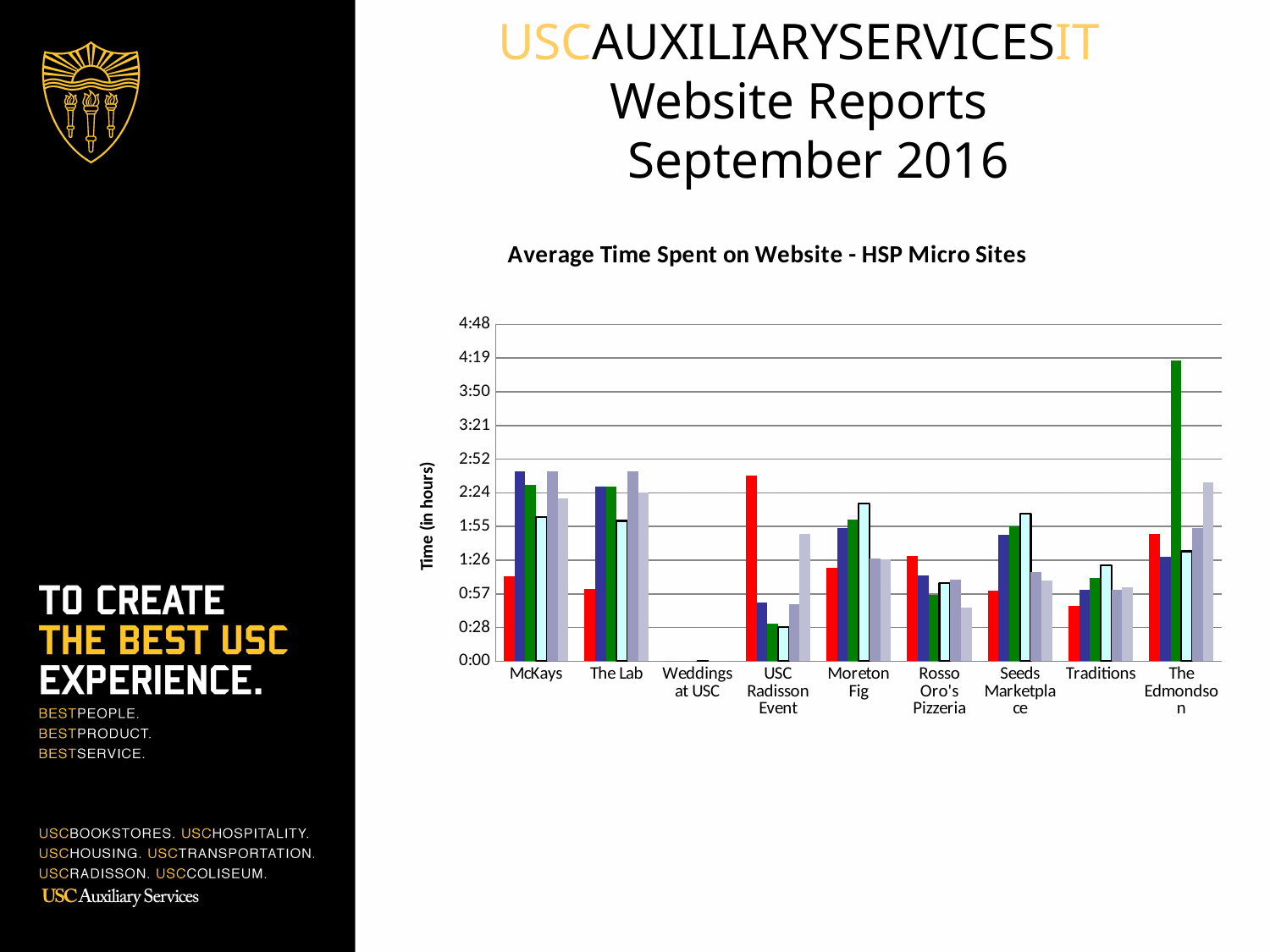
How many bars are plotted for McKays? 6 How many website categories are shown along the x axis? 9 Is the red bar for USC Radisson Event greater or less than 2:24? greater What kind of chart is shown on the slide? bar chart What is the title of the chart? Average Time Spent on Website - HSP Micro Sites What is the label on the vertical axis of the chart? Time (in hours) Which category contains the tallest bar in the chart? The Edmondson Is the red bar for Traditions greater or less than 0:57? less Which is larger: the green bar for The Edmondson or the green bar for McKays? The Edmondson Which category shows essentially no time spent (no visible bars)? Weddings at USC Which is larger: the red bar for USC Radisson Event or the red bar for McKays? USC Radisson Event Is the green bar for The Edmondson greater or less than 3:50? greater